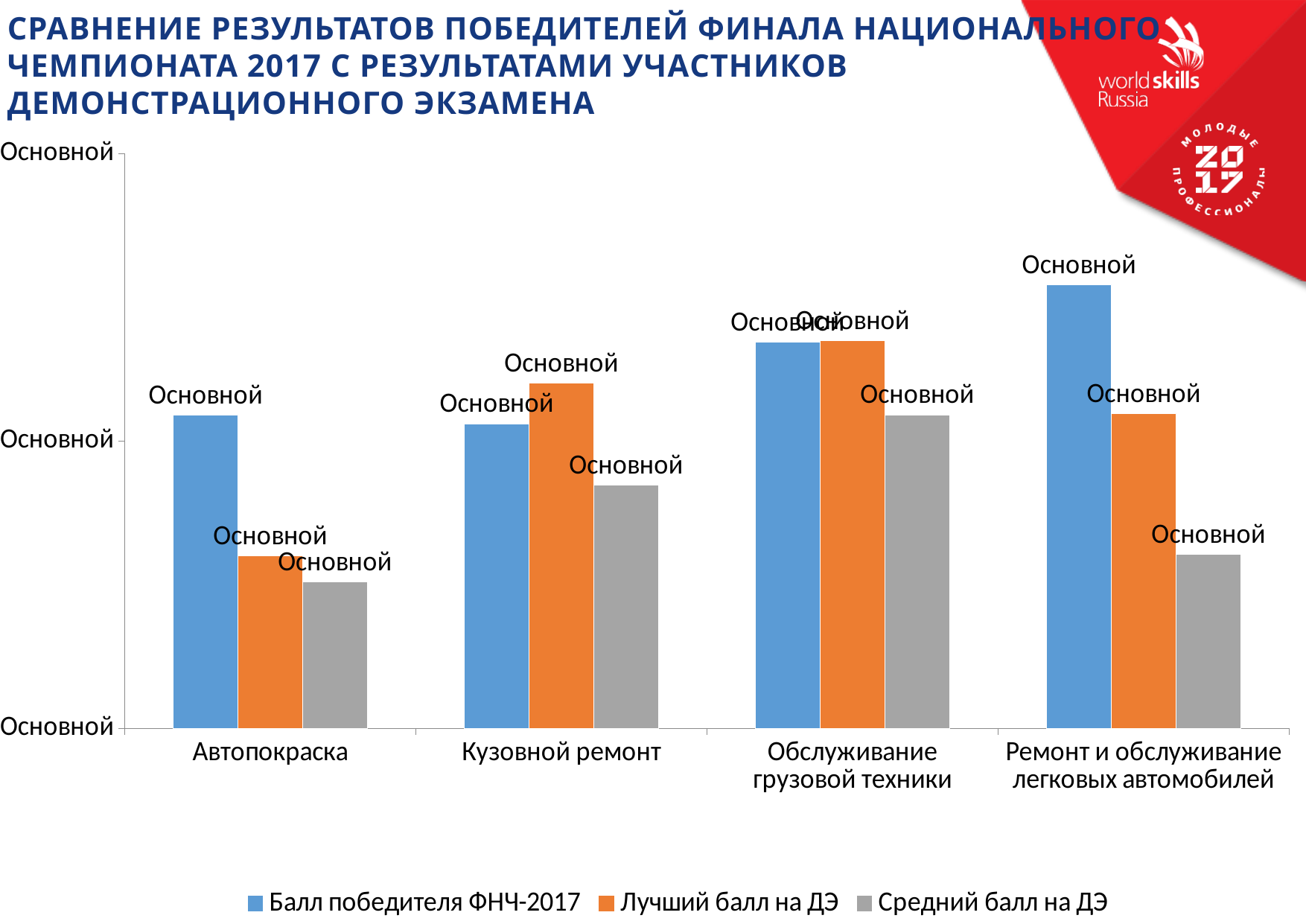
For which category is the Лучший балл на ДЭ bar the lowest? Автопокраска Is the Балл победителя ФНЧ-2017 value larger for Автопокраска or for Ремонт и обслуживание легковых автомобилей? Ремонт и обслуживание легковых автомобилей How many categories are shown on the x axis of the chart? 4 For which category is the Средний балл на ДЭ bar the highest? Обслуживание грузовой техники Which series is shown in grey in the chart? Средний балл на ДЭ What kind of chart is shown on the slide? Bar chart For which category is the Лучший балл на ДЭ bar the highest? Обслуживание грузовой техники In the Кузовной ремонт category, which series has the tallest bar? Лучший балл на ДЭ Which series is shown in blue in the chart? Балл победителя ФНЧ-2017 How many series does the chart legend list? 3 Is the Лучший балл на ДЭ value larger for Автопокраска or for Кузовной ремонт? Кузовной ремонт